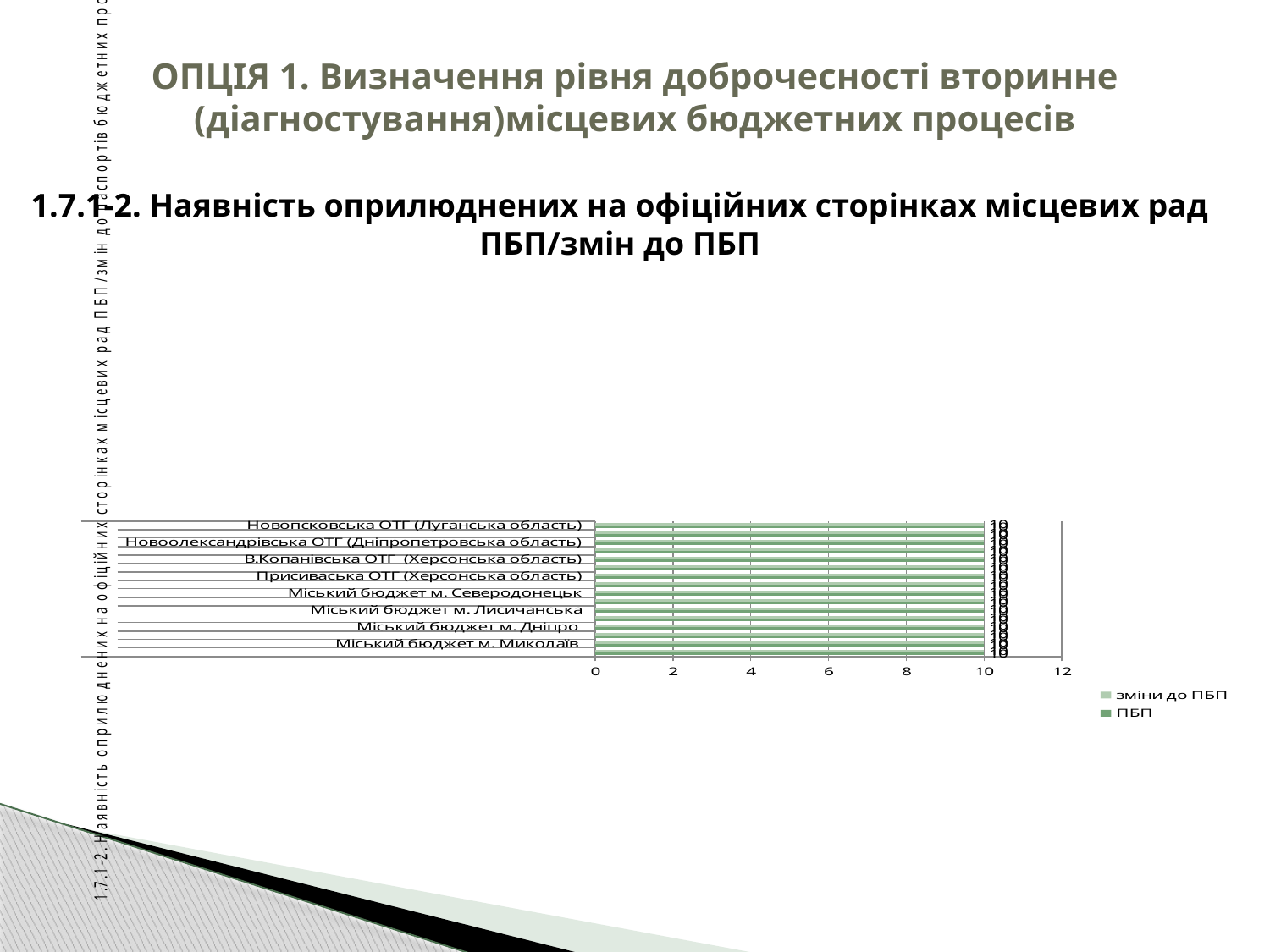
Is the value for Новопсковська ОТГ (Луганська область) greater or less than 6? greater What is the highest value shown on the chart's horizontal axis? 12 Is the value for В.Копанівська ОТГ (Херсонська область) greater or less than 2? greater How many series does the chart legend list? 2 What kind of chart is shown on the slide? bar chart Is the value for Міський бюджет м. Лисичанська greater or less than 4? greater What are the two series named in the chart legend? зміни до ПБП and ПБП What value is labelled on the bar for Присиваська ОТГ (Херсонська область)? 10 What value is labelled on the bar for Міський бюджет м. Северодонецьк? 10